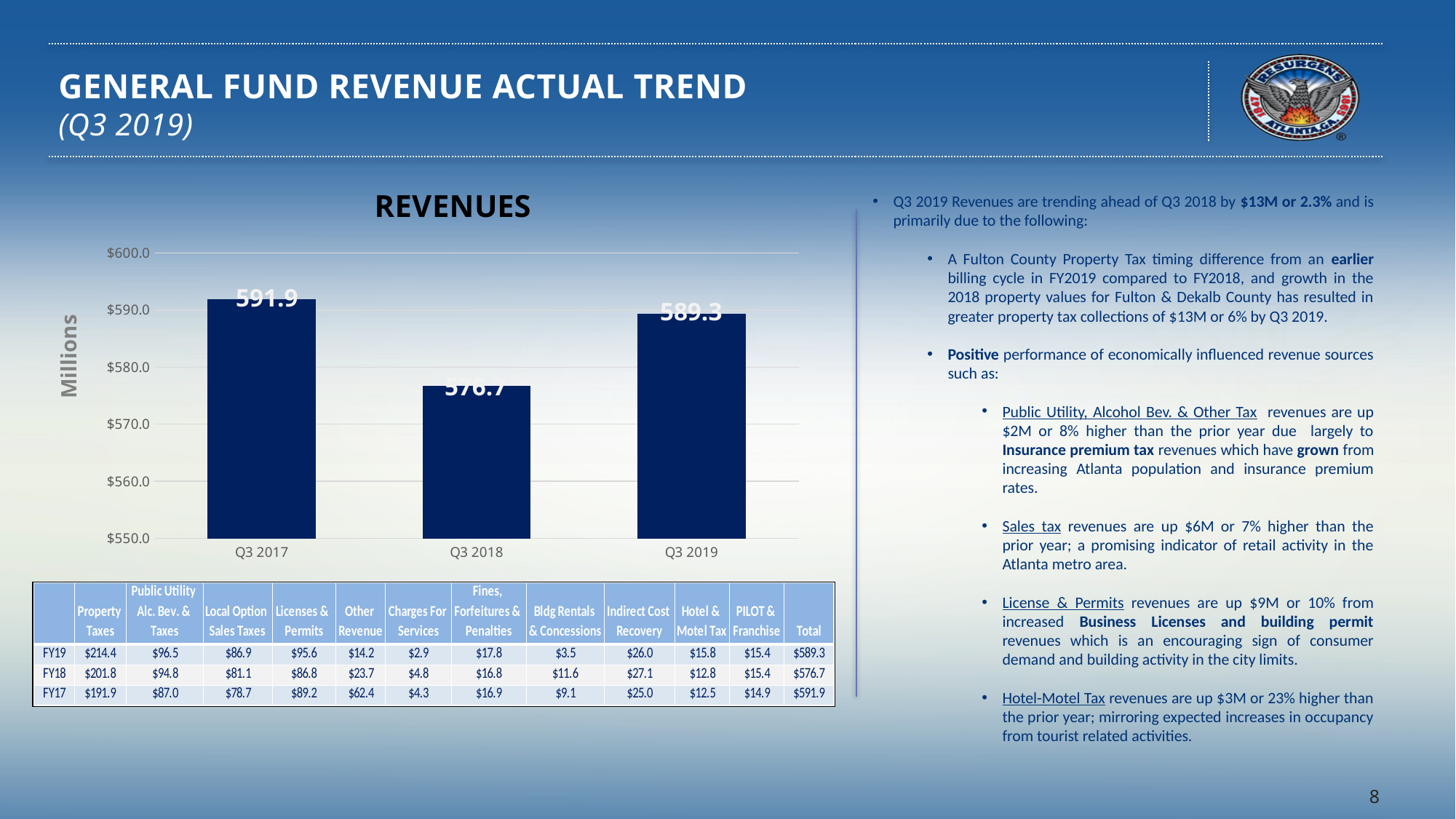
What is the value for Q3 2017 in the REVENUES chart? 591.9 What is the value for Q3 2018 in the REVENUES chart? 576.7 What is the difference between the Q3 2019 and Q3 2018 values in the REVENUES chart? 12.6 What type of chart is the REVENUES chart? bar chart Is the value for Q3 2018 in the REVENUES chart greater or less than $580.0? less How many bars are shown in the REVENUES chart? 3 Which quarter has the highest value in the REVENUES chart? Q3 2017 What is the value for Q3 2019 in the REVENUES chart? 589.3 What is the difference between the Q3 2017 and Q3 2018 values in the REVENUES chart? 15.2 Which quarter has the lowest value in the REVENUES chart? Q3 2018 What is the label on the vertical axis of the REVENUES chart? Millions Which is larger in the REVENUES chart, Q3 2017 or Q3 2019? Q3 2017